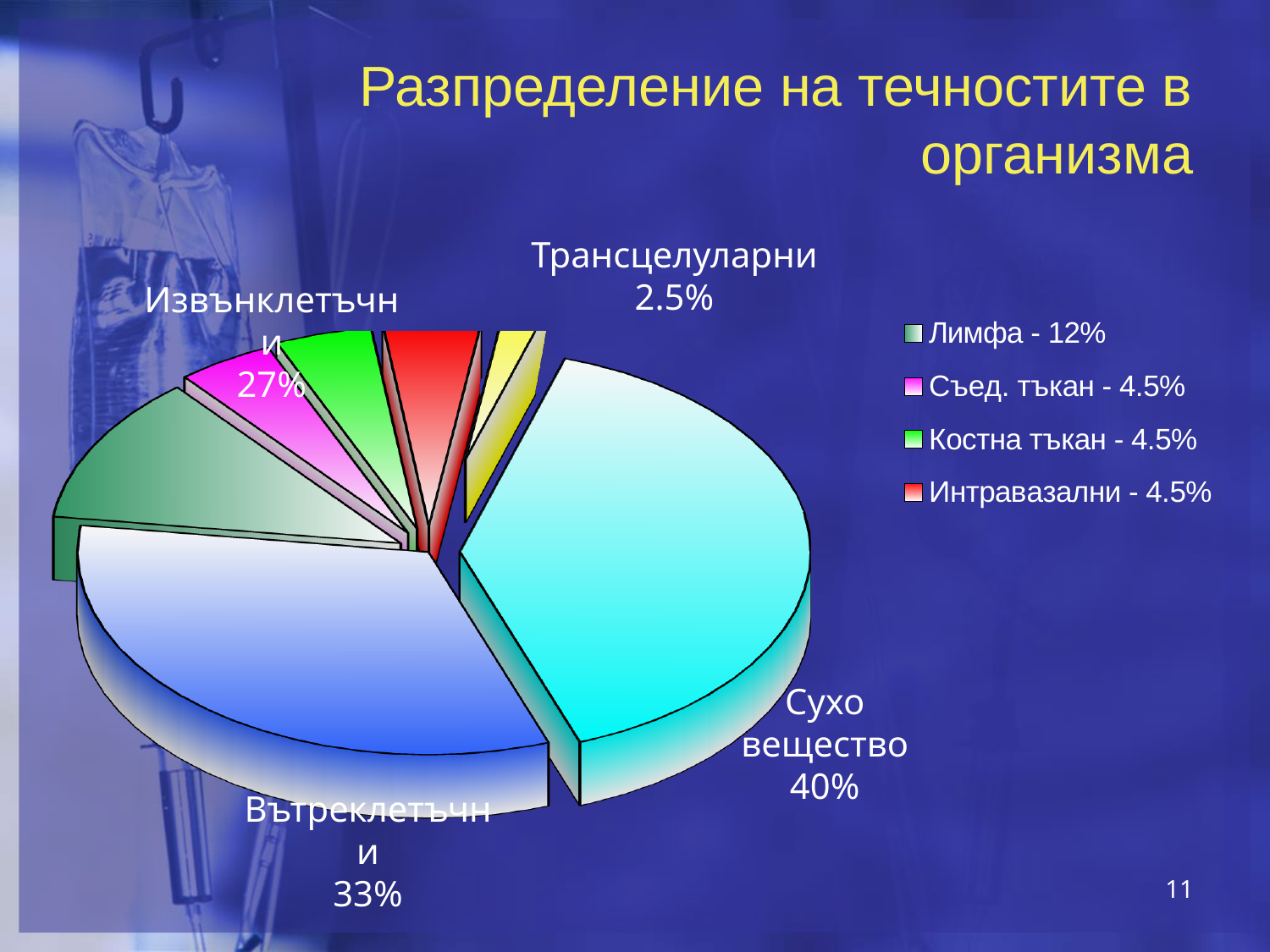
What percentage does the legend give for Костна тъкан? 4.5% What percentage is shown for Трансцелуларни? 2.5% What is the difference between the percentages for Сухо вещество and Вътреклетъчни? 7% What kind of chart is shown on the slide? pie chart What percentage does the legend give for Лимфа? 12% What is the title of the slide? Разпределение на течностите в организма Which labelled slice has the smallest share of the pie? Трансцелуларни Which labelled slice has the largest share of the pie? Сухо вещество How many entries does the legend list? 4 Which is larger, the share for Лимфа or the share for Съед. тъкан? Лимфа What percentage is shown for Сухо вещество? 40% What percentage is shown for Вътреклетъчни? 33%